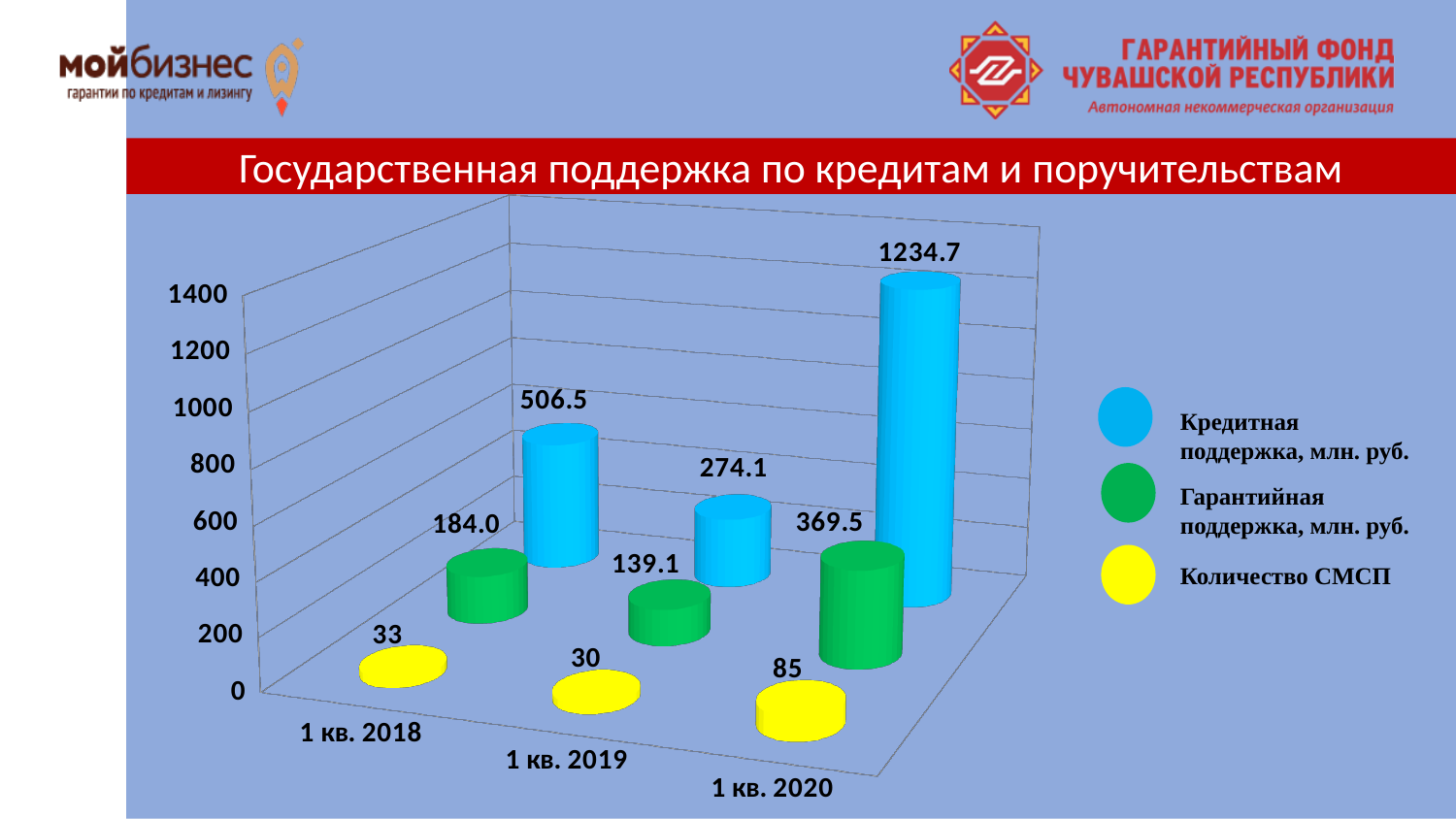
In which period is Гарантийная поддержка, млн. руб. the lowest? 1 кв. 2019 What is the value of Кредитная поддержка, млн. руб. for 1 кв. 2020? 1234.7 What colour represents Количество СМСП in the legend? yellow What is the difference between Кредитная поддержка, млн. руб. in 1 кв. 2020 and 1 кв. 2019? 960.6 What is the Количество СМСП for 1 кв. 2019? 30 What is the value of Гарантийная поддержка, млн. руб. for 1 кв. 2018? 184.0 Which is larger: Гарантийная поддержка, млн. руб. in 1 кв. 2018 or in 1 кв. 2020? 1 кв. 2020 What kind of chart is shown on the slide? bar chart How many periods are shown on the x axis? 3 In which period is Кредитная поддержка, млн. руб. the highest? 1 кв. 2020 What is the difference in Количество СМСП between 1 кв. 2020 and 1 кв. 2018? 52 How many series does the legend list? 3